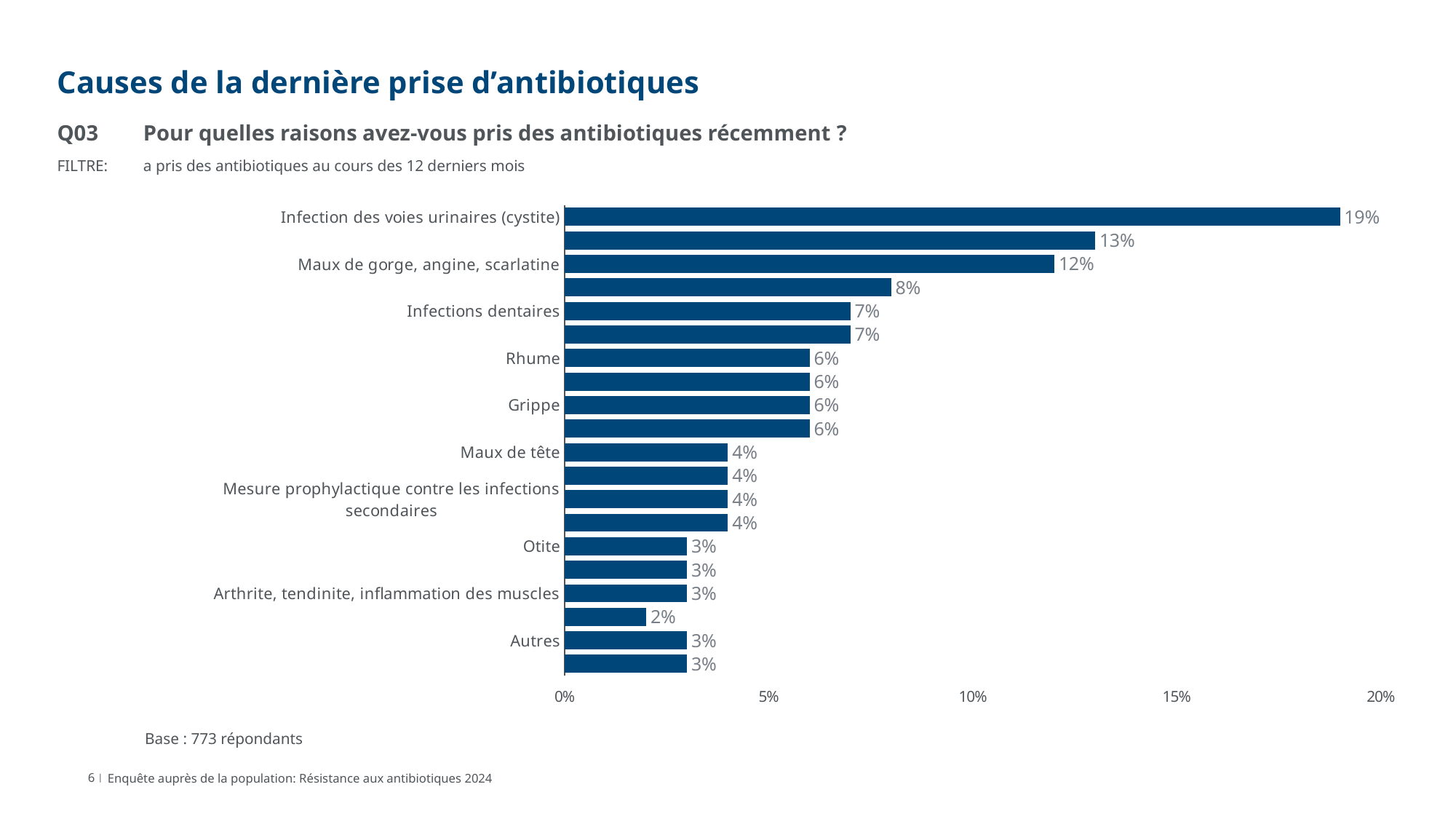
What is the difference between the values for Infection des voies urinaires (cystite) and Maux de gorge, angine, scarlatine? 7 percentage points Which is larger, the value for Infections dentaires or the value for Rhume? Infections dentaires How many respondents form the base of the chart, as stated on the slide? 773 répondants What is the value for Maux de tête? 4% What is the value for Autres? 3% What type of chart is shown on the slide? bar chart Is the value for Maux de gorge, angine, scarlatine greater or less than 10%? greater What is the value for Infections dentaires? 7% What is the smallest value printed on any bar in the chart? 2% What is the value for Infection des voies urinaires (cystite)? 19% Which category has the highest value? Infection des voies urinaires (cystite) What is the value for Maux de gorge, angine, scarlatine? 12%